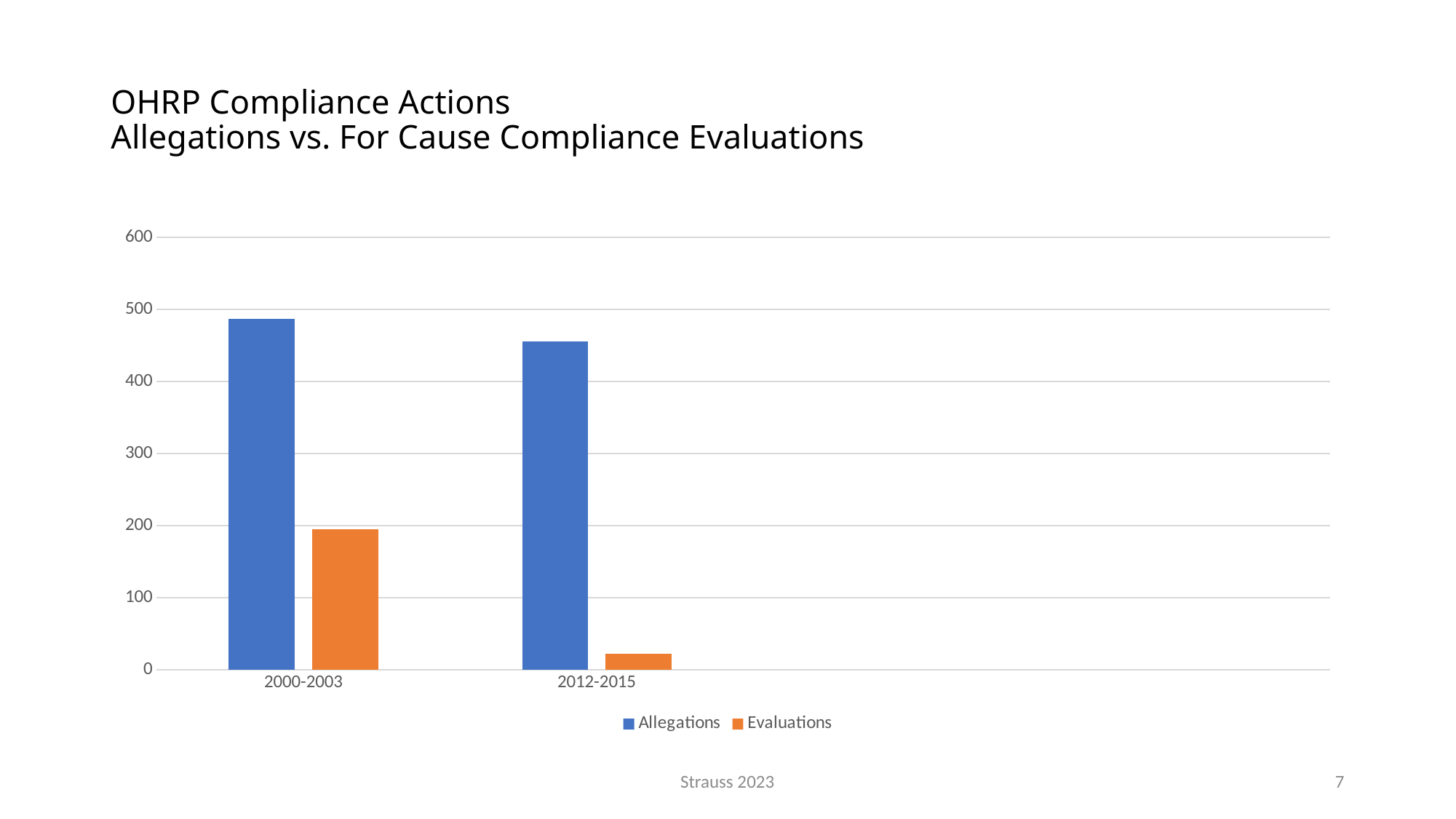
What kind of chart is shown on the slide? bar chart Is the Evaluations value for 2000-2003 greater or less than 100? greater What colour are the Evaluations bars? orange Do the Evaluations values rise or fall from 2000-2003 to 2012-2015? fall How many categories are shown on the x axis? 2 Is the Allegations value for 2000-2003 greater or less than 400? greater How many series does the legend list? 2 Which category has the lowest Evaluations value? 2012-2015 Which series has the higher value for 2000-2003, Allegations or Evaluations? Allegations Is the Evaluations value for 2012-2015 greater or less than 100? less Which series has the higher value for 2012-2015, Allegations or Evaluations? Allegations